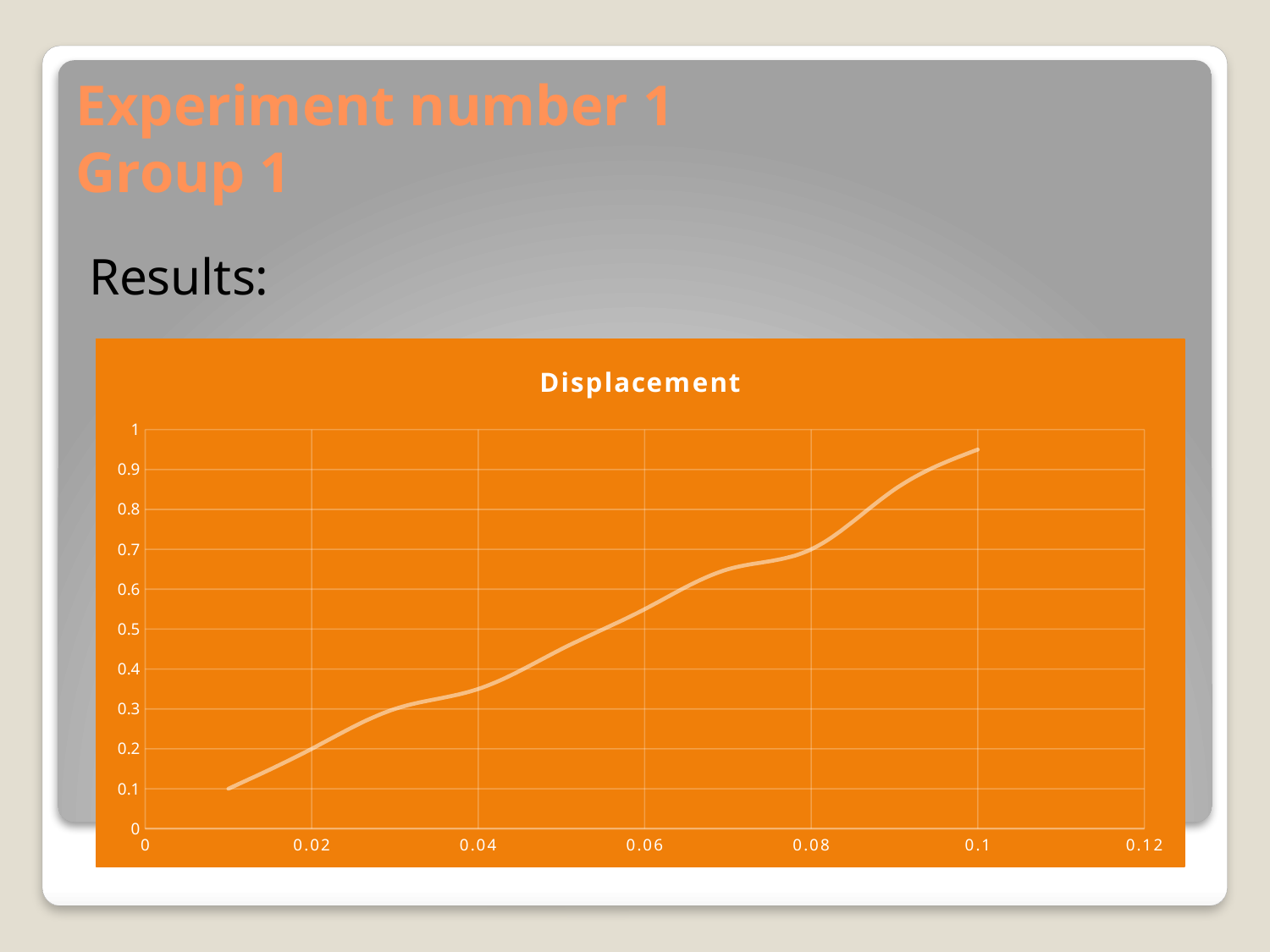
Is the value of the line at x = 0.04 greater or less than 0.3? greater What is the largest value labelled on the x axis of the chart? 0.12 Is the value of the line at x = 0.04 greater or less than 0.4? less Is the value of the line at x = 0.06 greater or less than 0.6? less At which labelled x value does the line reach its highest point? 0.1 What is the title of the chart? Displacement Does the plotted line rise or fall as the x value increases from 0 to 0.1? rise What kind of chart is shown on the slide? line chart